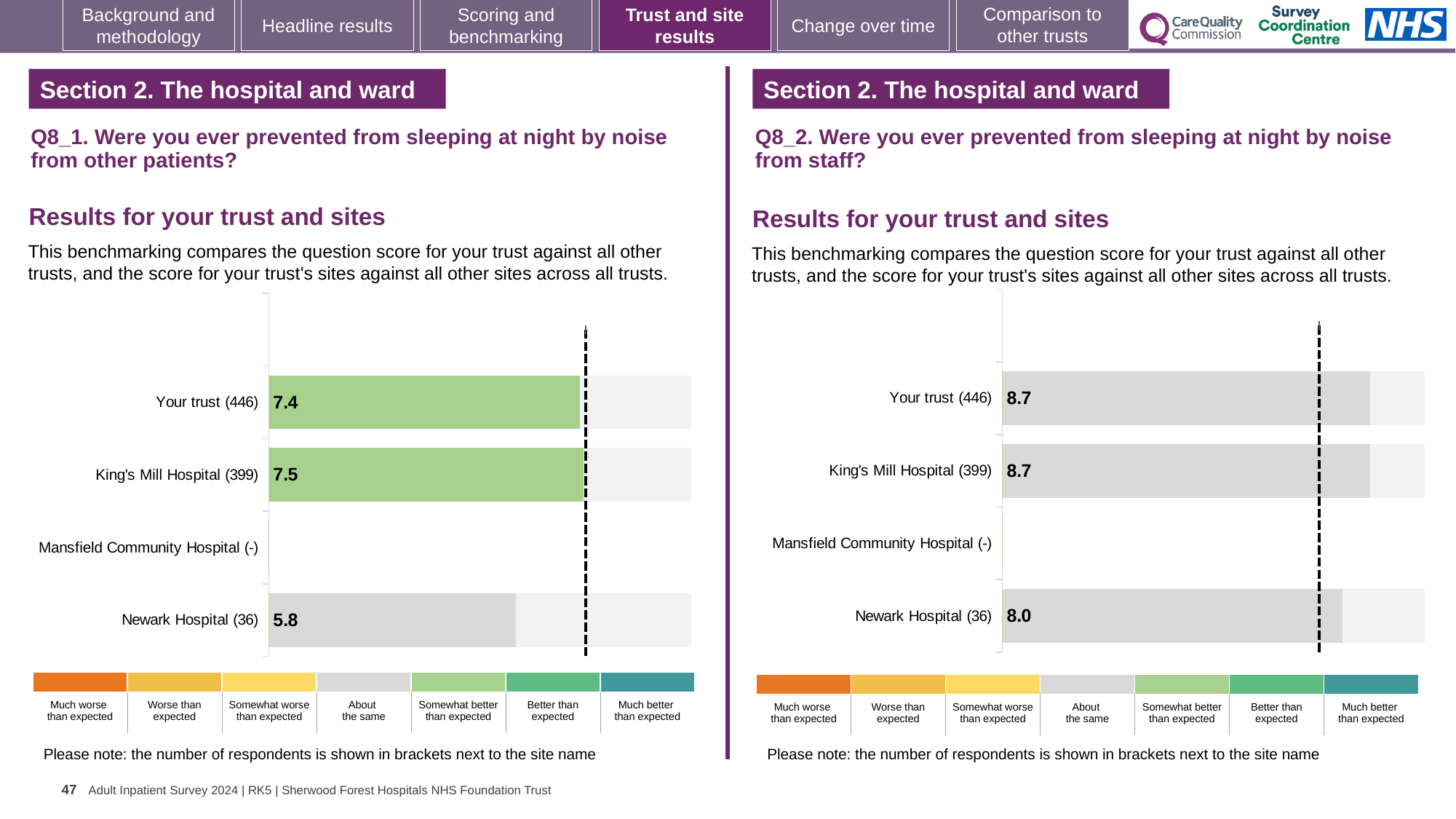
In the Q8_1 chart (noise from other patients), which site has the lowest score? Newark Hospital (36) In the Q8_1 chart (noise from other patients), what is the difference between the King's Mill Hospital score and the Newark Hospital score? 1.7 In the Q8_2 chart (noise from staff), what is the score for King's Mill Hospital (399)? 8.7 In the Q8_1 chart (noise from other patients), what is the score for Your trust (446)? 7.4 How many sites or rows are listed on the y axis of the Q8_1 chart (noise from other patients)? 4 In the Q8_1 chart (noise from other patients), which site has no score shown? Mansfield Community Hospital (-) In the Q8_2 chart (noise from staff), what is the score for Newark Hospital (36)? 8.0 What kind of chart is used for the Q8_2 results (noise from staff)? Bar chart In the Q8_2 chart (noise from staff), what is the difference between the Your trust score and the Newark Hospital score? 0.7 In the Q8_1 chart (noise from other patients), what is the score for Newark Hospital (36)? 5.8 How many categories does the colour legend below the Q8_1 chart list? 7 In the Q8_2 chart (noise from staff), which is larger: the score for Your trust or the score for Newark Hospital? Your trust